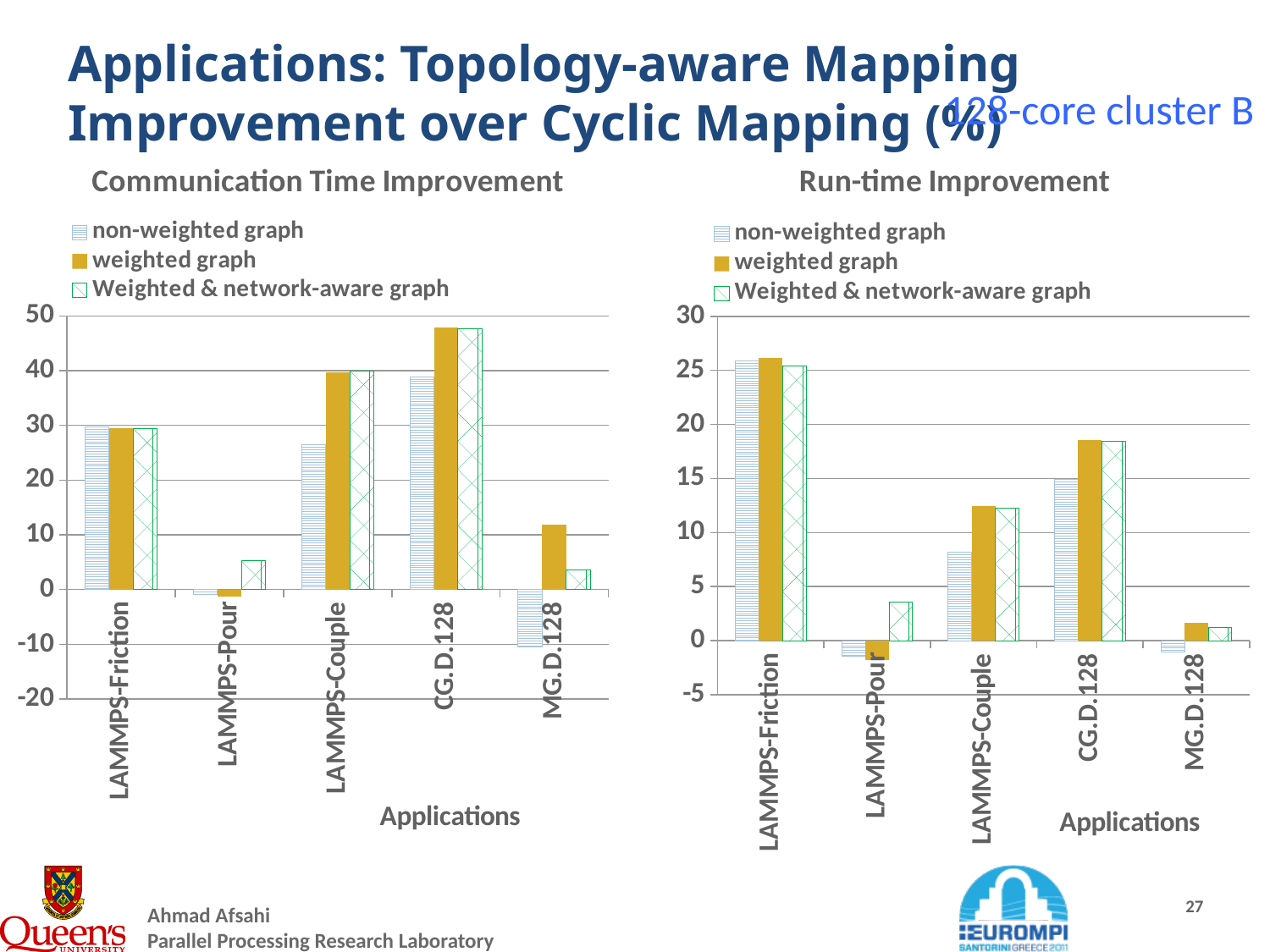
In the Communication Time Improvement chart, is the weighted graph value for CG.D.128 greater or less than 40? greater How many series does the legend of the Run-time Improvement chart list? 3 In the Communication Time Improvement chart, for MG.D.128, which is larger: the weighted graph value or the Weighted & network-aware graph value? weighted graph In the Run-time Improvement chart, which application has the highest non-weighted graph value? LAMMPS-Friction In the Run-time Improvement chart, which has the larger weighted graph value, CG.D.128 or LAMMPS-Couple? CG.D.128 What is the x-axis title of the Run-time Improvement chart? Applications In the Communication Time Improvement chart, is the non-weighted graph value for LAMMPS-Couple greater or less than 30? less In the Run-time Improvement chart, is the weighted graph value for LAMMPS-Couple greater or less than 10? greater What kind of chart is the Communication Time Improvement chart? bar chart In the Communication Time Improvement chart, which application has the lowest non-weighted graph value? MG.D.128 How many application categories are shown on the x axis of the Communication Time Improvement chart? 5 In the Communication Time Improvement chart, which application has the highest weighted graph value? CG.D.128